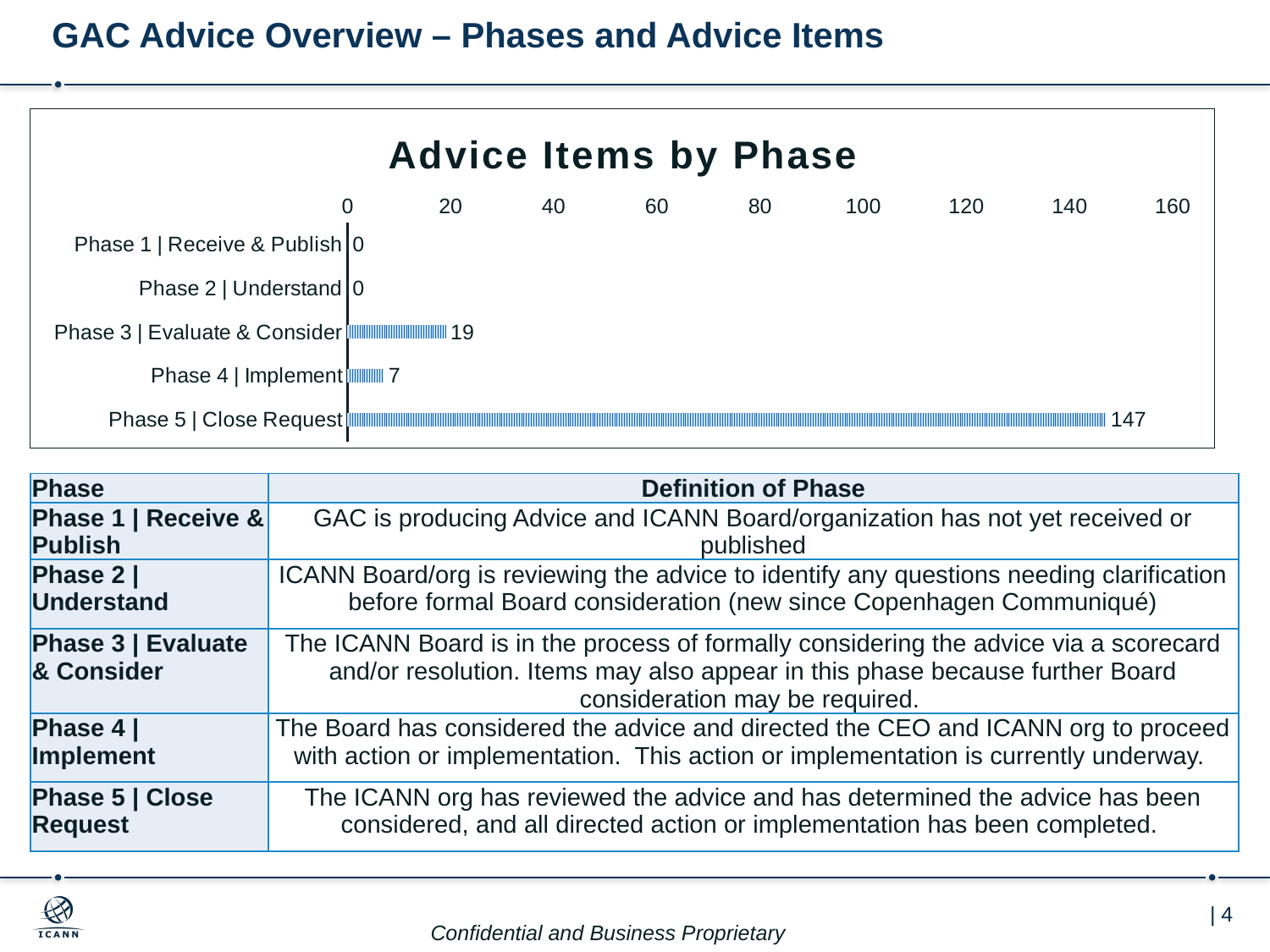
What is the difference between the values for Phase 5 | Close Request and Phase 3 | Evaluate & Consider? 128 What is the value for Phase 4 | Implement in the Advice Items by Phase chart? 7 Is the value for Phase 5 | Close Request greater or less than 140? greater Which is larger in the chart: the value for Phase 3 | Evaluate & Consider or Phase 4 | Implement? Phase 3 | Evaluate & Consider What is the value for Phase 5 | Close Request in the Advice Items by Phase chart? 147 What is the value for Phase 3 | Evaluate & Consider in the Advice Items by Phase chart? 19 What kind of chart is the Advice Items by Phase chart? Bar chart What is the title of the chart on the slide? Advice Items by Phase What is the difference between the values for Phase 3 | Evaluate & Consider and Phase 4 | Implement? 12 Which phase has the highest number of advice items in the chart? Phase 5 | Close Request How many phases are shown in the Advice Items by Phase chart? 5 What is the value for Phase 1 | Receive & Publish in the Advice Items by Phase chart? 0